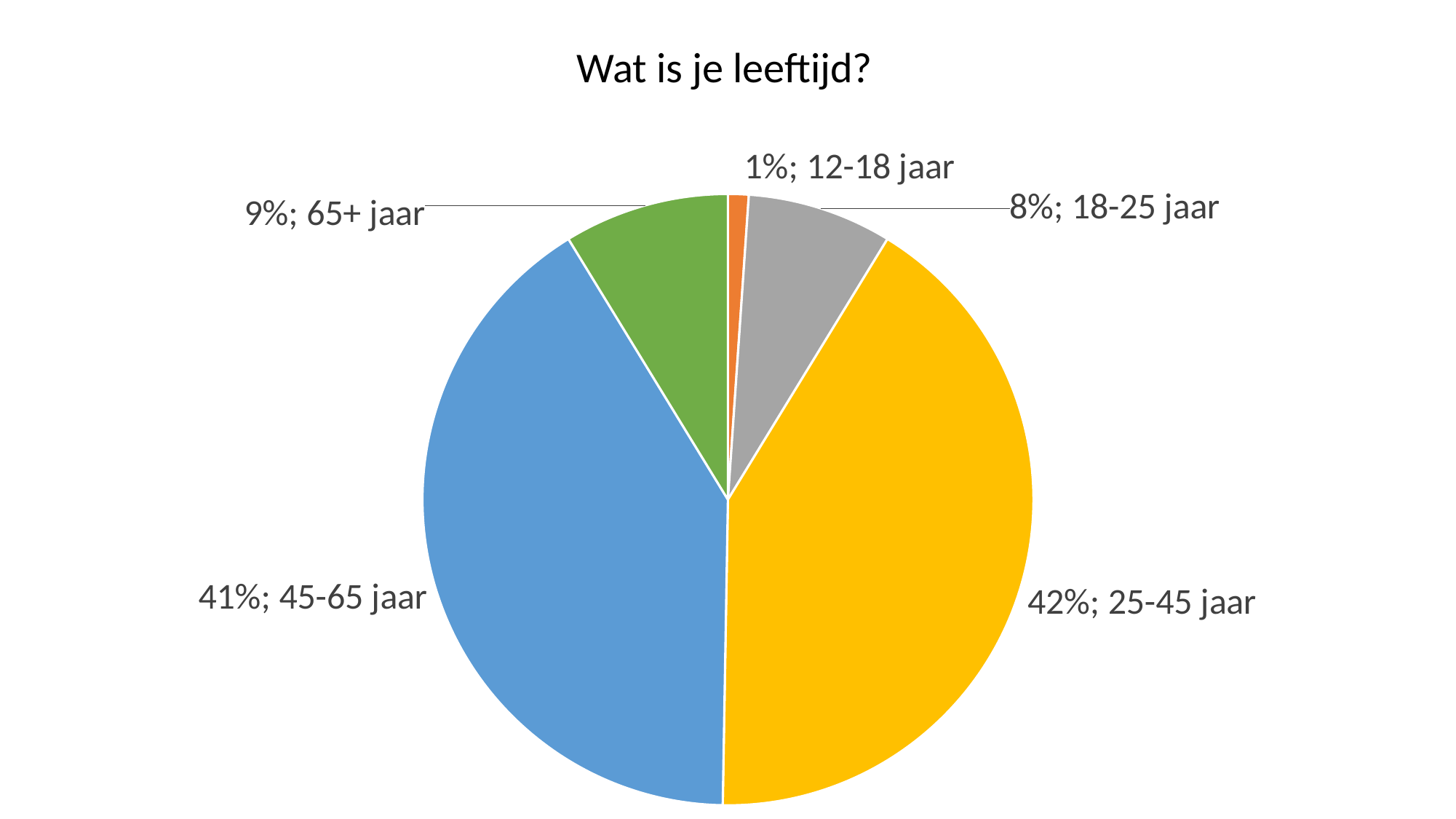
What share of the pie is the 45-65 jaar slice? 41% Which age group has the smallest share? 12-18 jaar What is the difference between the 25-45 jaar and 45-65 jaar shares? 1% What share of the pie is the 25-45 jaar slice? 42% Which is larger, the share for 65+ jaar or for 18-25 jaar? 65+ jaar What is the value for 12-18 jaar? 1% What is the value for 65+ jaar? 9% How many age groups are shown in the pie chart? 5 Which age group has the largest share? 25-45 jaar What is the title of the chart? Wat is je leeftijd? What kind of chart is shown on the slide? pie chart What is the value for 18-25 jaar? 8%